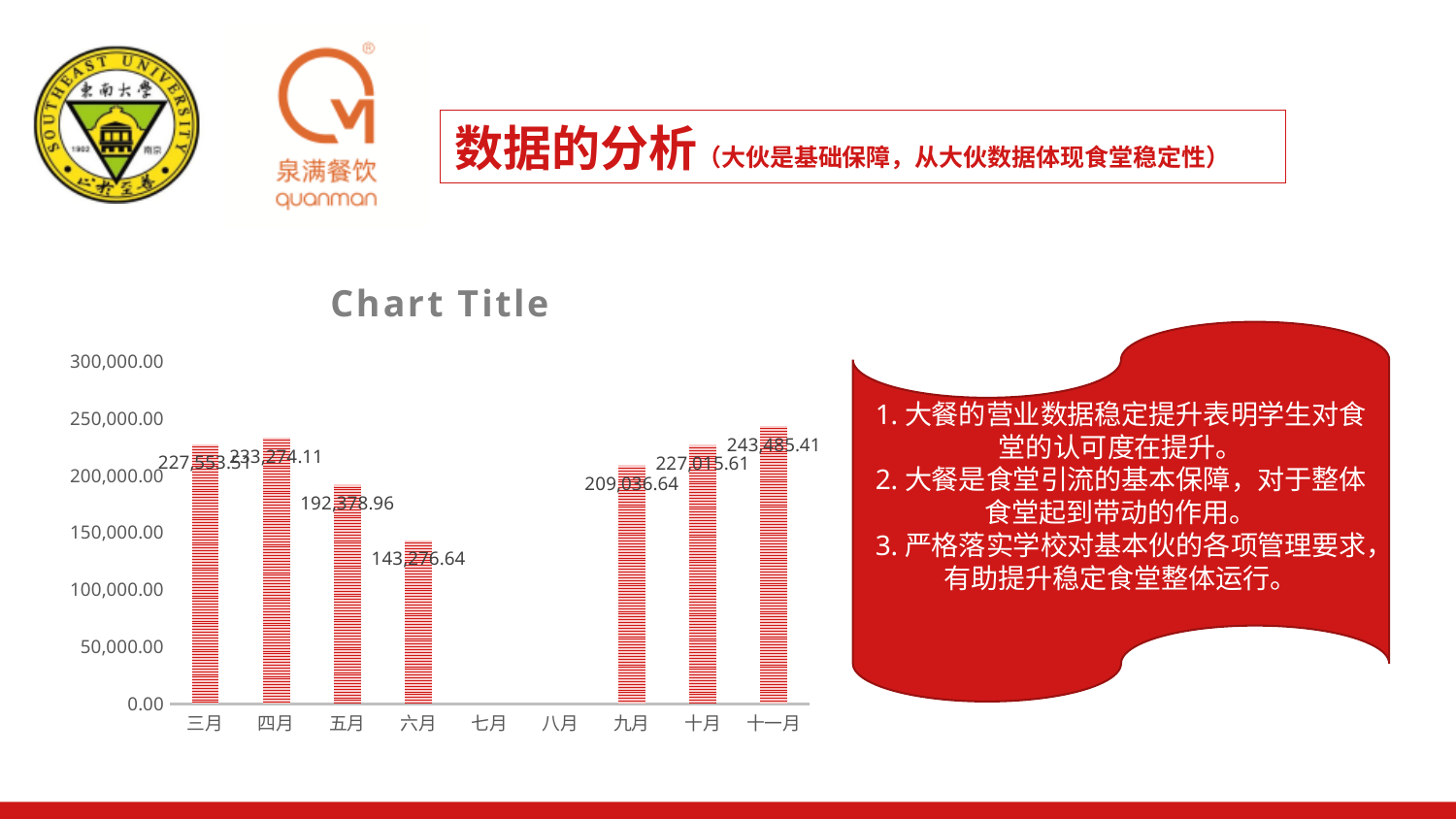
Among the months with a bar, which has the lowest value? 六月 What is the value for 十一月? 243,485.41 Is the value for 六月 greater or less than 150,000.00? less What is the value for 九月? 209,036.64 What is the difference between the values for 九月 and 六月? 65,760.00 What kind of chart is shown? bar chart Which is larger, the value for 四月 or the value for 五月? 四月 What is the value for 六月? 143,276.64 Which month has the highest value? 十一月 What is the difference between the values for 十一月 and 十月? 16,469.80 How many months are listed on the x axis? 9 What is the value for 十月? 227,015.61